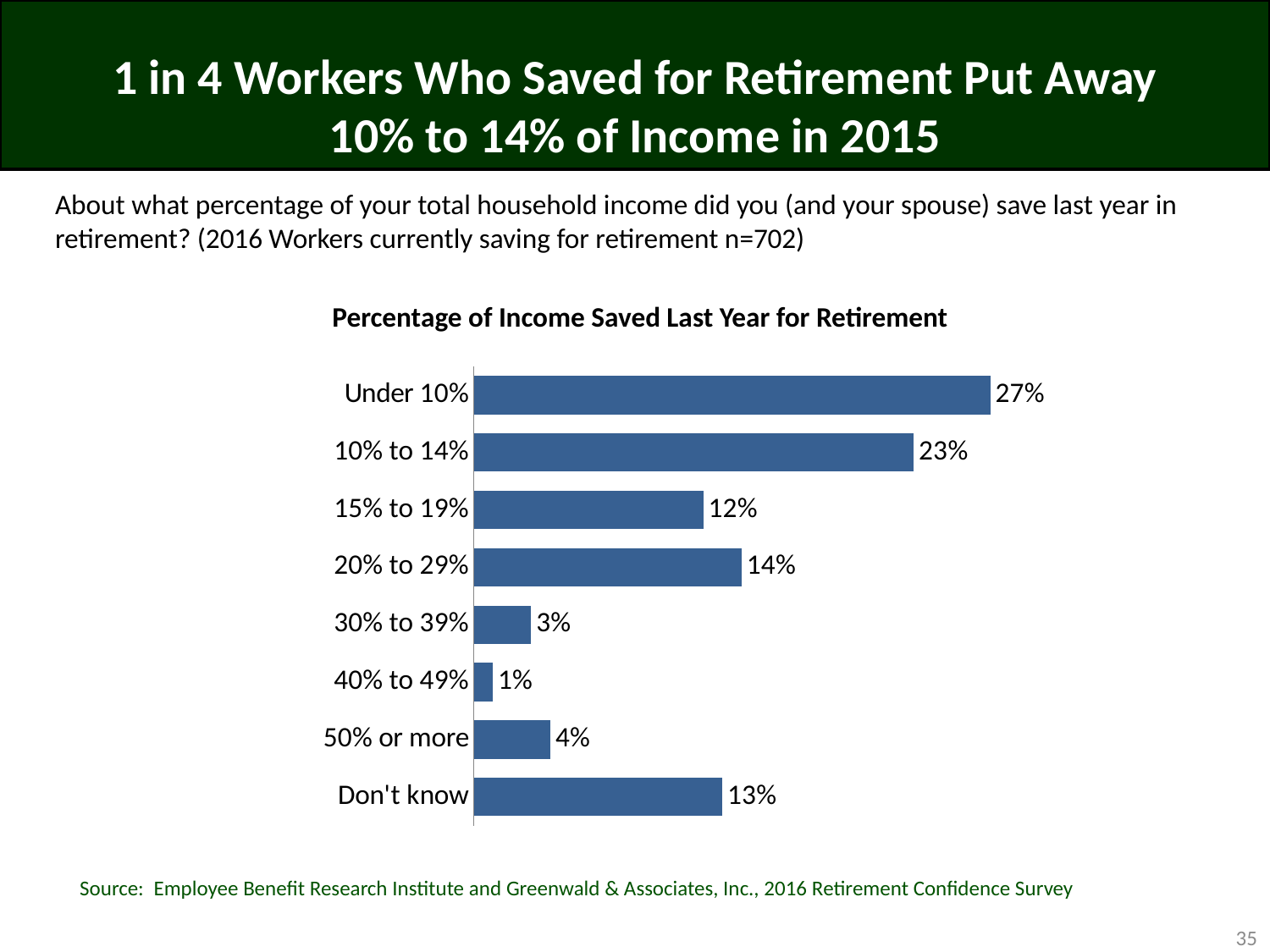
Which category has the highest value? Under 10% Which is larger, the value for '15% to 19%' or the value for '20% to 29%'? 20% to 29% What is the difference between the '20% to 29%' and '15% to 19%' values? 2 percentage points What type of chart is shown on the slide? Bar chart Which category has the lowest value? 40% to 49% What is the difference between the 'Under 10%' and '10% to 14%' values? 4 percentage points What is the title of the chart? Percentage of Income Saved Last Year for Retirement What is the value for the '50% or more' category? 4% What is the value for the '10% to 14%' category? 23% How many categories are shown in the chart? 8 What percentage of workers saved under 10% of income for retirement? 27% What percentage of workers answered 'Don't know'? 13%